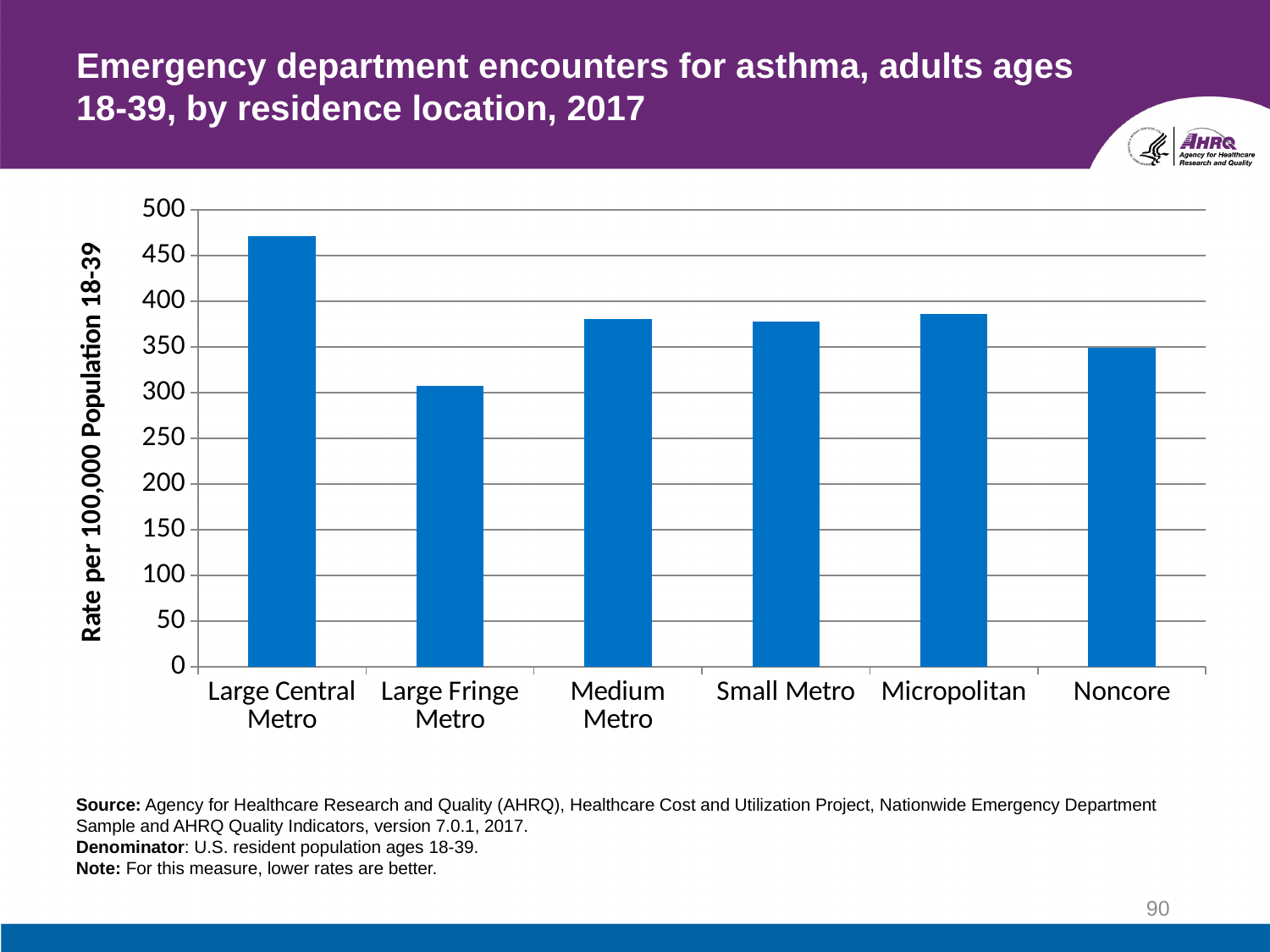
What is the label on the vertical axis of the chart? Rate per 100,000 Population 18-39 Is the value for Micropolitan greater or less than 400? less Which has a higher rate, Micropolitan or Large Fringe Metro? Micropolitan How many residence location categories are shown on the chart? 6 Is the value for Medium Metro greater or less than 350? greater Which residence location has the highest rate of emergency department encounters for asthma? Large Central Metro Is the value for Large Central Metro greater or less than 450? greater Which has a higher rate, Large Central Metro or Noncore? Large Central Metro What kind of chart is shown on the slide? Bar chart Which residence location has the lowest rate of emergency department encounters for asthma? Large Fringe Metro